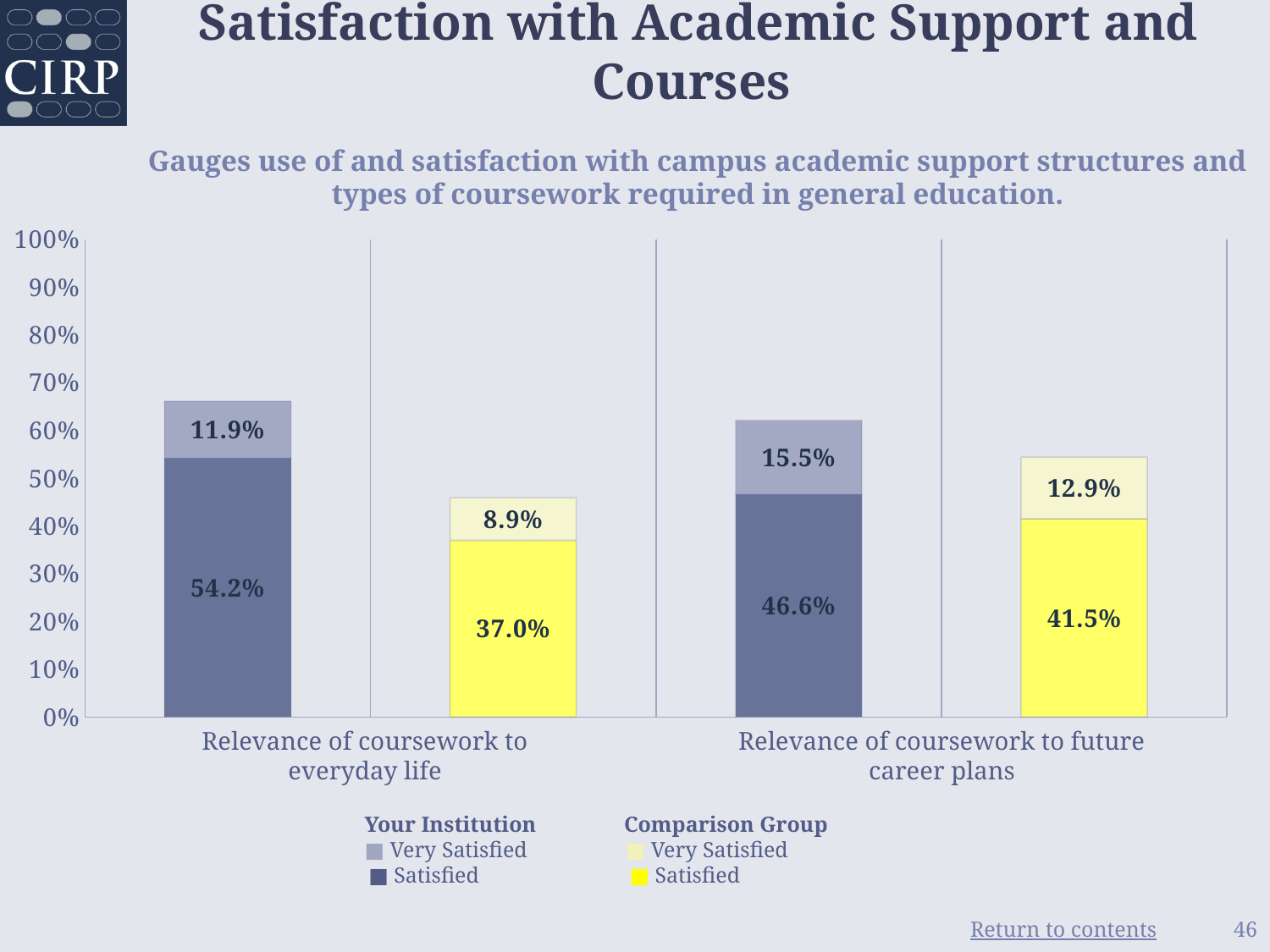
Which Satisfied value is the lowest across all four bars? 37.0% What is the combined Satisfied and Very Satisfied total for the Comparison Group on relevance of coursework to future career plans? 54.4% How many series does the legend list? 4 What percentage of the Comparison Group were Satisfied with the relevance of coursework to everyday life? 37.0% What type of chart is shown on the slide? Stacked bar chart What percentage of Your Institution respondents were Very Satisfied with the relevance of coursework to future career plans? 15.5% What is the difference between the Satisfied percentages for Your Institution and the Comparison Group on relevance of coursework to everyday life? 17.2% Is the total stacked bar for the Comparison Group on relevance of coursework to everyday life greater or less than 50%? less What is the combined Satisfied and Very Satisfied total for Your Institution on relevance of coursework to everyday life? 66.1% Which group has the larger Very Satisfied percentage for relevance of coursework to future career plans, Your Institution or the Comparison Group? Your Institution What percentage of Your Institution respondents were Satisfied with the relevance of coursework to everyday life? 54.2% What percentage of the Comparison Group were Very Satisfied with the relevance of coursework to future career plans? 12.9%